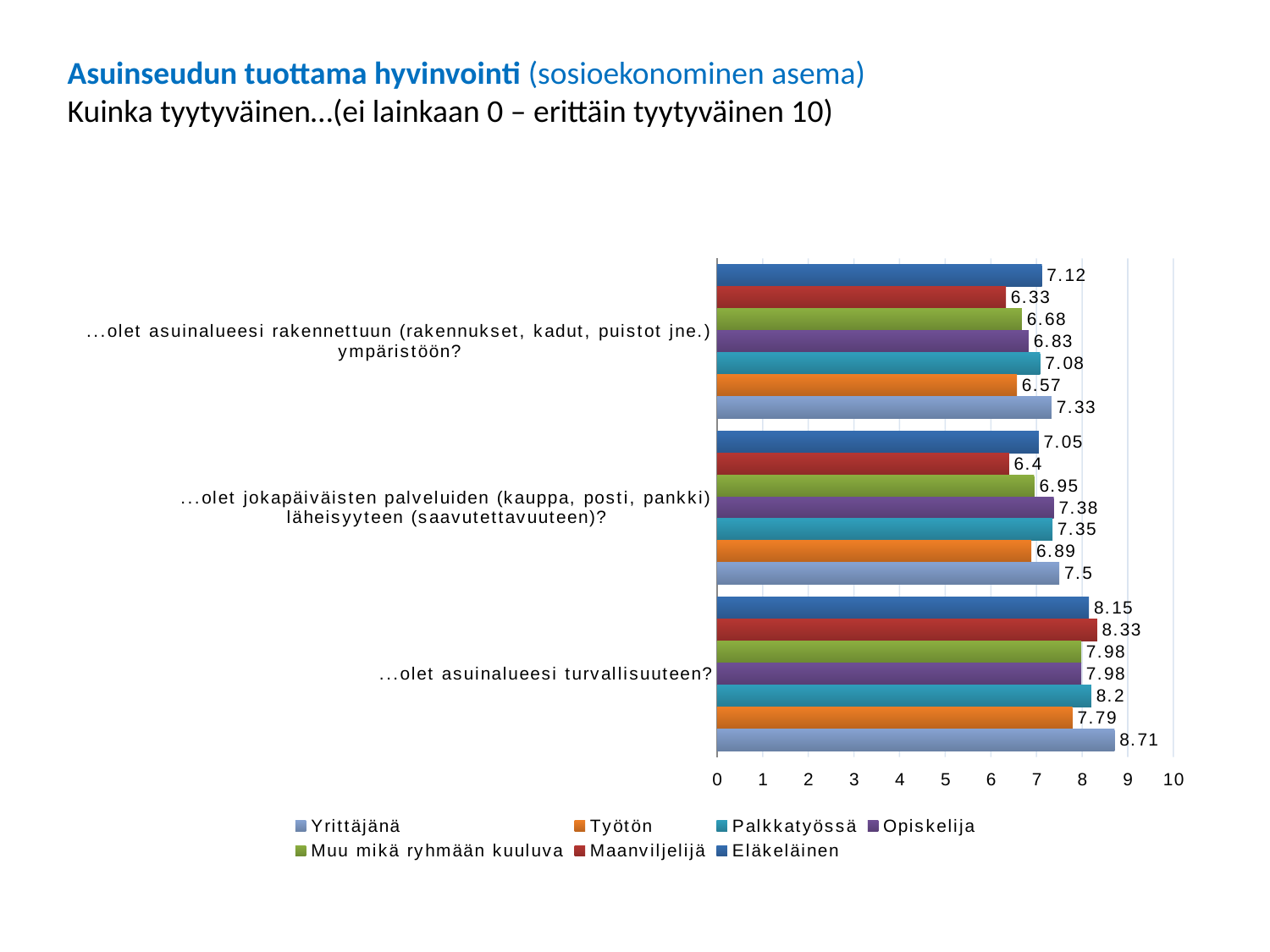
What is the value for Eläkeläinen for '...olet asuinalueesi rakennettuun (rakennukset, kadut, puistot jne.) ympäristöön?' 7.12 Which is larger for '...olet jokapäiväisten palveluiden (kauppa, posti, pankki) läheisyyteen (saavutettavuuteen)?': Työtön or Palkkatyössä? Palkkatyössä What is the difference between the Yrittäjänä and Työtön values for '...olet asuinalueesi turvallisuuteen?' 0.92 What kind of chart is shown on the slide? bar chart What is the maximum value shown on the horizontal axis? 10 Which series has the highest value for '...olet asuinalueesi turvallisuuteen?' Yrittäjänä How many series does the legend list? 7 How many question categories are plotted on the chart? 3 What is the value for Yrittäjänä for '...olet asuinalueesi turvallisuuteen?' 8.71 Which series has the lowest value for '...olet asuinalueesi rakennettuun (rakennukset, kadut, puistot jne.) ympäristöön?' Maanviljelijä What is the value for Maanviljelijä for '...olet jokapäiväisten palveluiden (kauppa, posti, pankki) läheisyyteen (saavutettavuuteen)?' 6.4 What is the difference between the Maanviljelijä and Eläkeläinen values for '...olet asuinalueesi turvallisuuteen?' 0.18